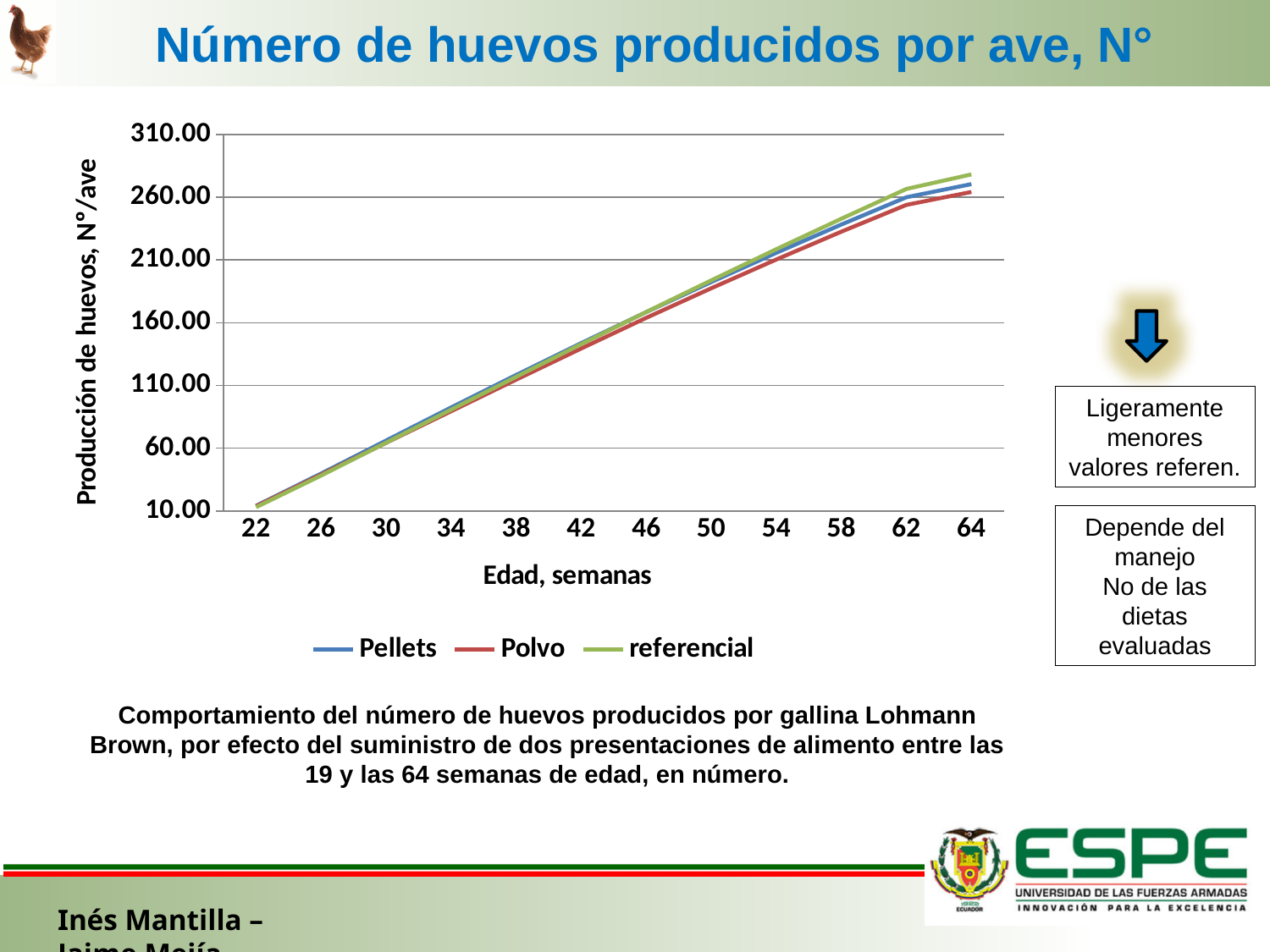
Is the value for referencial at week 64 greater or less than 260.00? greater How many series does the legend list? 3 Which series has the highest value at week 64? referencial What is the title of the x axis? Edad, semanas What kind of chart is shown on the slide? line chart At week 64, which is larger, the value for Pellets or the value for Polvo? Pellets How many age labels are shown on the x axis? 12 Is the value for Pellets at week 42 greater or less than 160.00? less What are the series names listed in the legend? Pellets, Polvo, referencial Do the values of the Polvo series rise or fall along the x axis? rise Do the values of the Pellets series rise or fall as age in weeks increases? rise Which series has the lowest value at week 64? Polvo